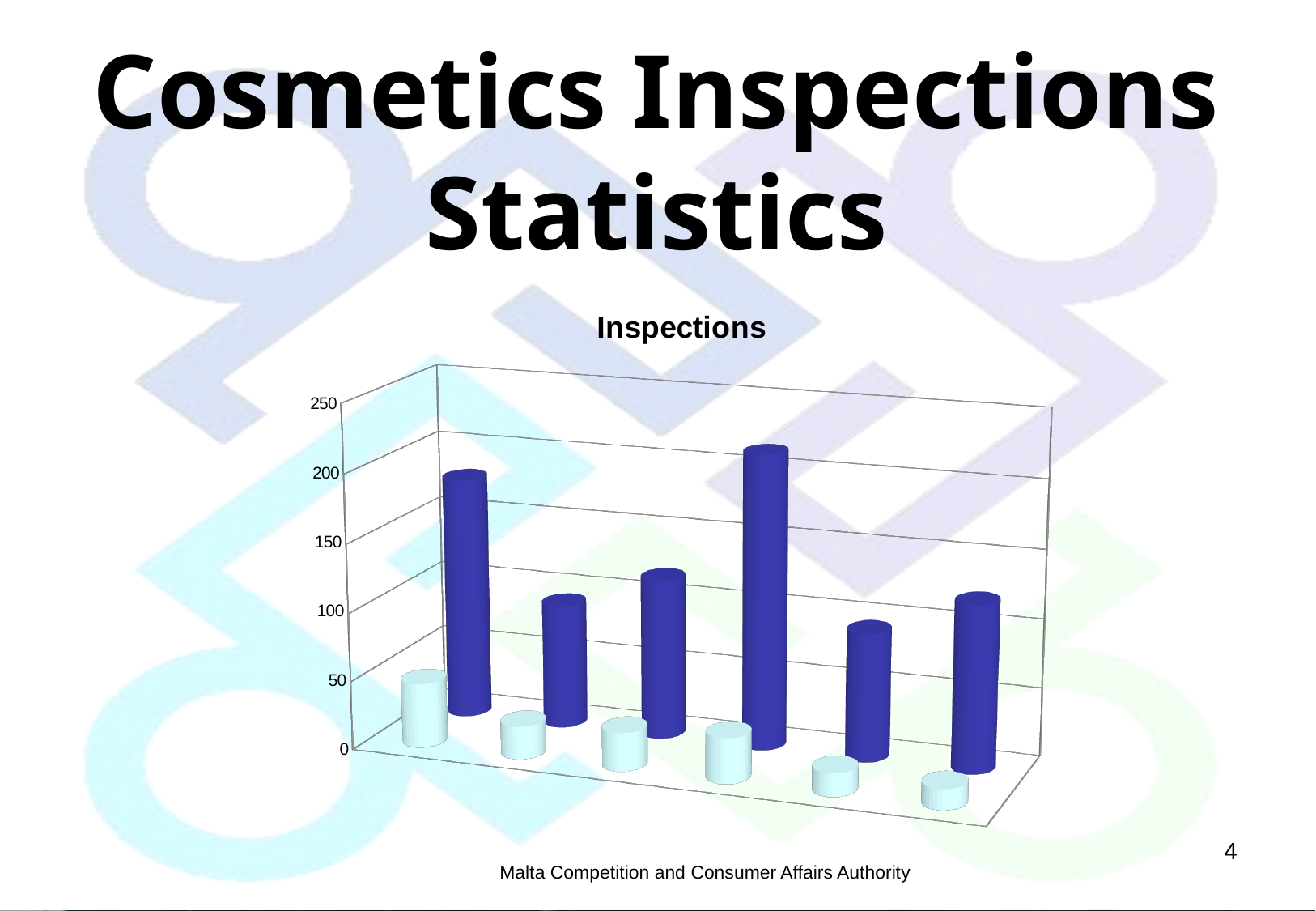
What kind of chart is shown on the slide? bar chart Which of the dark blue bars is the tallest? the fourth from the left What is the title of the chart? Inspections Which series has the taller bar in every group, the dark blue series or the light blue series? the dark blue series What is the highest value shown on the vertical axis? 250 Is the tallest light blue bar greater or less than 100? less How many groups of bars are plotted along the x axis? 6 Which is taller, the first dark blue bar from the left or the fourth dark blue bar from the left? the fourth dark blue bar Is the fourth dark blue bar from the left greater or less than 100? greater